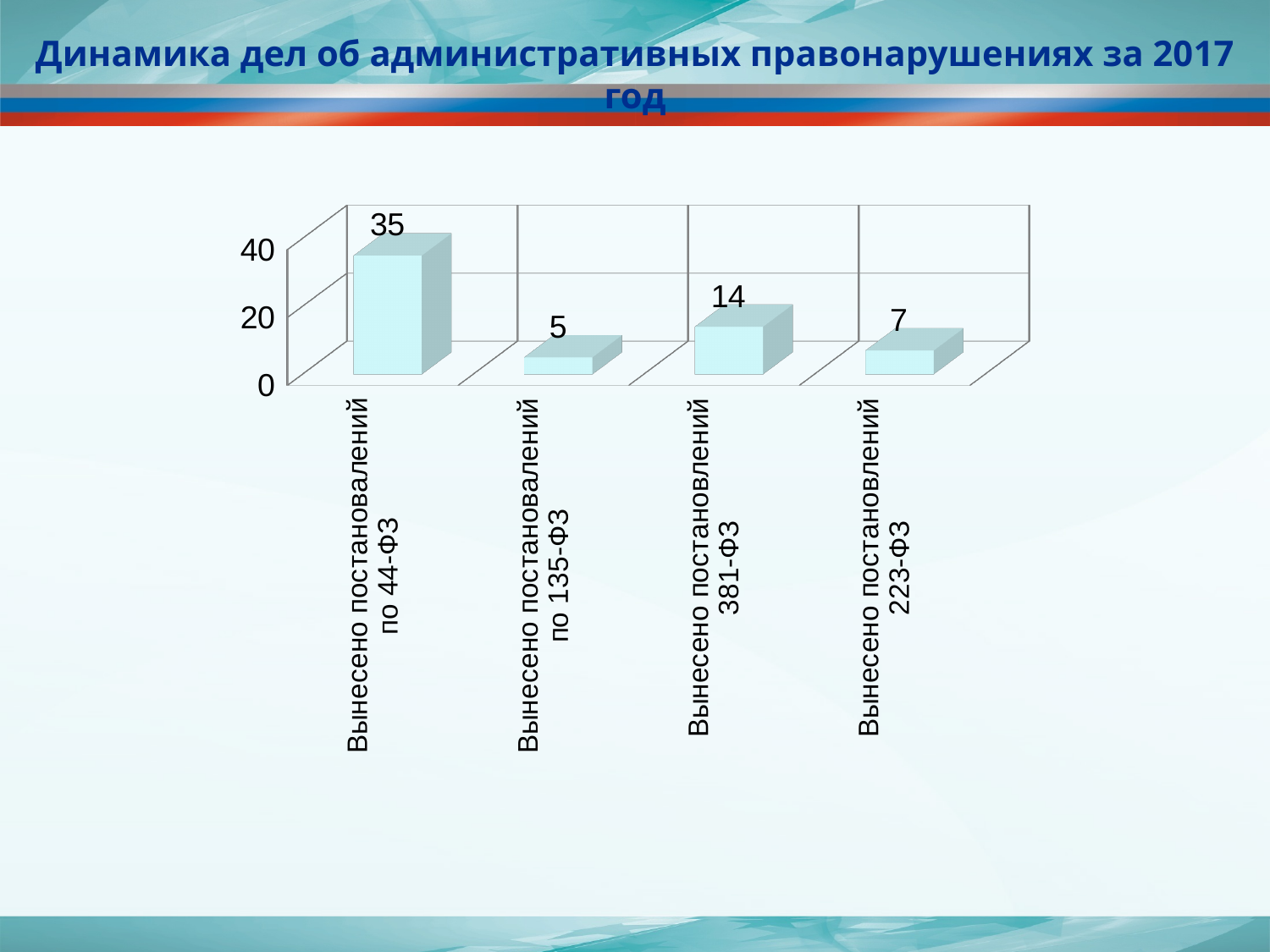
What is the value for "Вынесено постановлений 381-ФЗ"? 14 Which category has the lowest value? Вынесено постановалений по 135-ФЗ What is the difference between the values for 223-ФЗ and 135-ФЗ? 2 Which is larger, the value for 381-ФЗ or the value for 223-ФЗ? 381-ФЗ How many categories are shown in the chart? 4 What kind of chart is shown on the slide? bar chart What is the difference between the values for 44-ФЗ and 381-ФЗ? 21 What is the value for "Вынесено постановалений по 135-ФЗ"? 5 Is the value for 44-ФЗ greater or less than 20? greater What is the value for "Вынесено постановлений 223-ФЗ"? 7 Which category has the highest value? Вынесено постановалений по 44-ФЗ What is the value for "Вынесено постановалений по 44-ФЗ"? 35